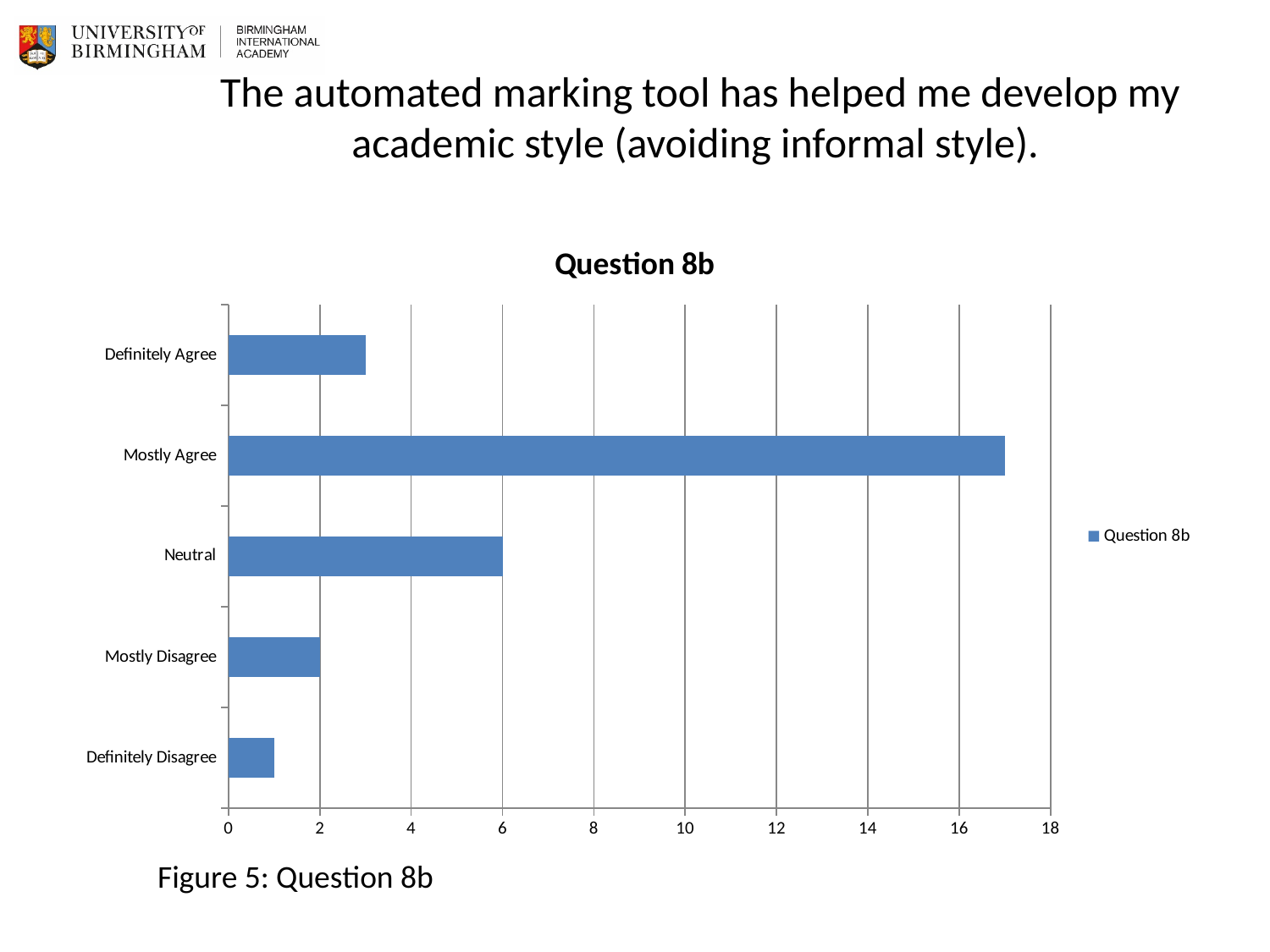
Is the value for Definitely Agree greater or less than 4? less How many series does the legend list? 1 What is the title of the chart? Question 8b Which category has the lowest value? Definitely Disagree What is the difference between the values for Neutral and Mostly Disagree? 4 Is the value for Mostly Agree greater or less than 16? greater What is the value for Neutral? 6 Which category has the highest value? Mostly Agree What kind of chart is shown on the slide? bar chart What is the value for Mostly Disagree? 2 How many categories are shown on the chart? 5 Which is larger, the value for Neutral or the value for Definitely Agree? Neutral